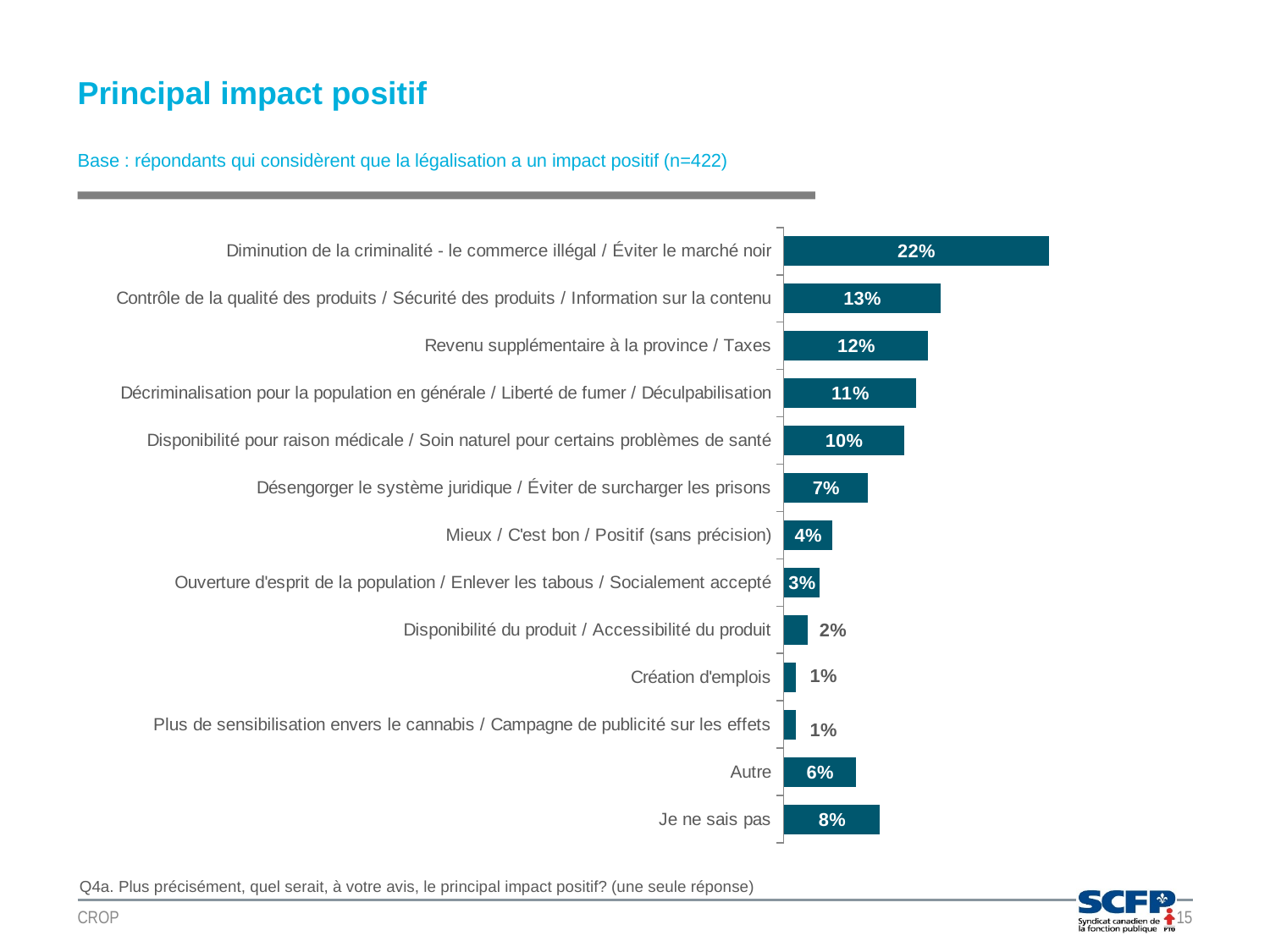
What is the value for "Revenu supplémentaire à la province / Taxes"? 12% What is the difference between the values for "Contrôle de la qualité des produits / Sécurité des produits / Information sur la contenu" and "Désengorger le système juridique / Éviter de surcharger les prisons"? 6% Which category has the highest value? Diminution de la criminalité - le commerce illégal / Éviter le marché noir What is the value for "Autre"? 6% Which is larger: the value for "Disponibilité pour raison médicale / Soin naturel pour certains problèmes de santé" or the value for "Mieux / C'est bon / Positif (sans précision)"? Disponibilité pour raison médicale / Soin naturel pour certains problèmes de santé What is the title of the chart on the slide? Principal impact positif What is the difference between the values for "Diminution de la criminalité - le commerce illégal / Éviter le marché noir" and "Je ne sais pas"? 14% How many categories are shown in the chart? 13 What kind of chart is shown on the slide? Bar chart What is the value for "Je ne sais pas"? 8% What is the value for "Création d'emplois"? 1% What is the value for "Diminution de la criminalité - le commerce illégal / Éviter le marché noir"? 22%